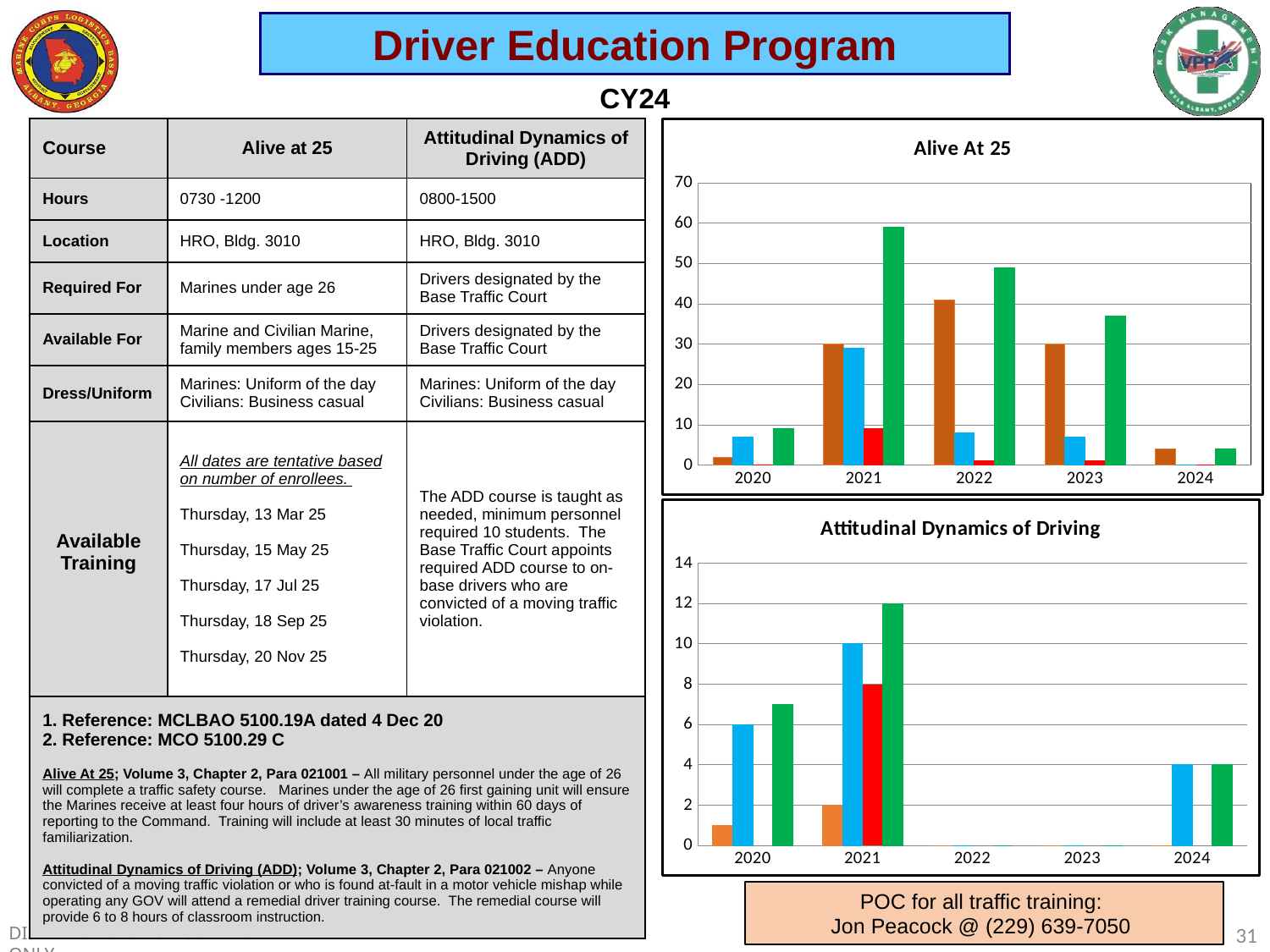
What kind of chart is the 'Attitudinal Dynamics of Driving' chart? bar chart How many years are shown on the x axis of the 'Alive At 25' chart? 5 In the 'Alive At 25' chart, is the tallest bar for 2023 greater or less than 30? greater In the 'Alive At 25' chart, is the tallest bar for 2022 greater or less than 40? greater In the 'Attitudinal Dynamics of Driving' chart, which years have no bars plotted? 2022 and 2023 In the 'Alive At 25' chart, is the tallest bar for 2021 greater or less than 50? greater What kind of chart is the 'Alive At 25' chart? bar chart In the 'Attitudinal Dynamics of Driving' chart, what is the value of the bars shown for 2024? 4 In the 'Attitudinal Dynamics of Driving' chart, what is the value of the tallest bar for 2021? 12 In the 'Alive At 25' chart, which year has the tallest bar? 2021 In the 'Attitudinal Dynamics of Driving' chart, which year has the tallest bar? 2021